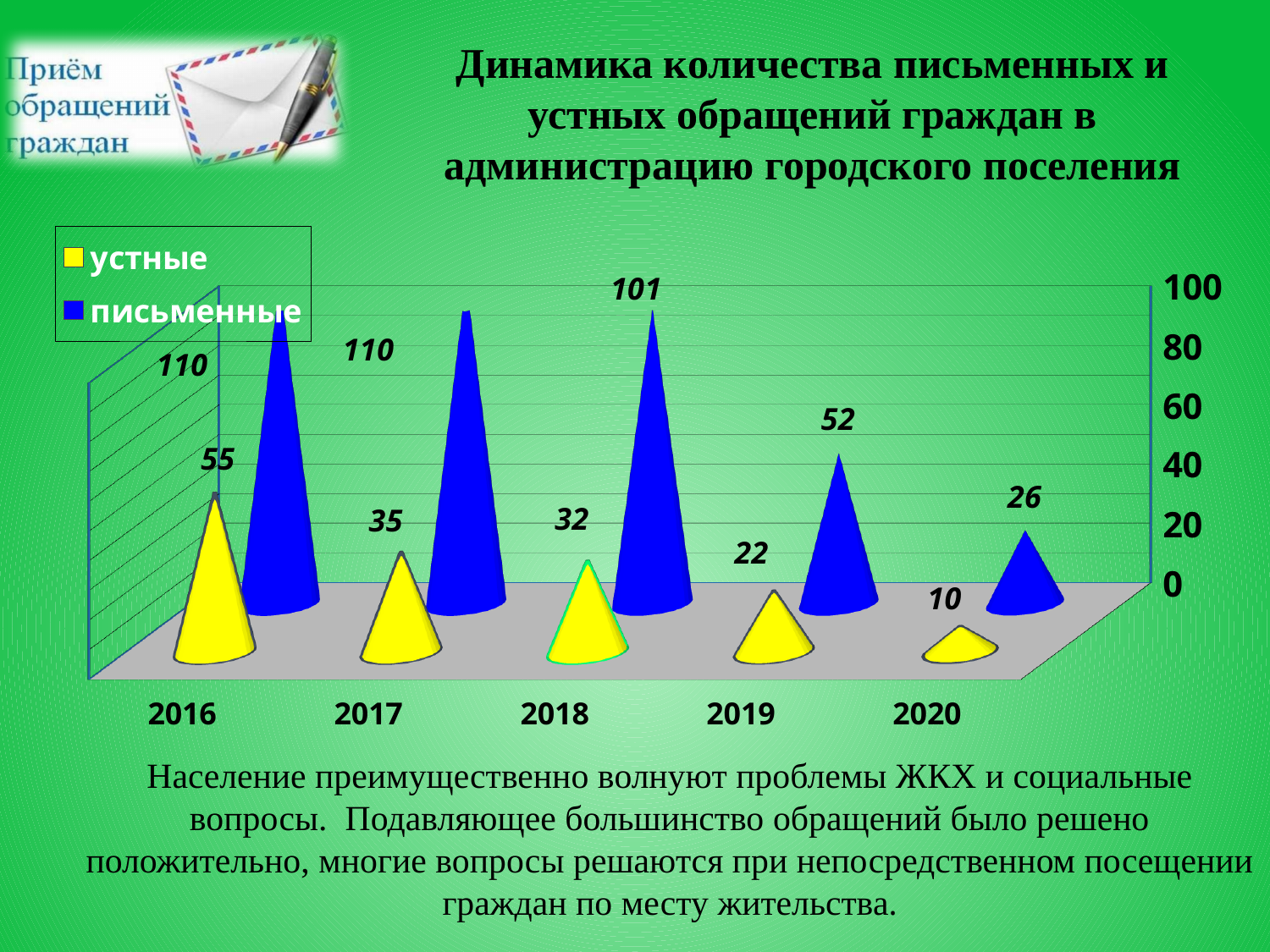
Do the values for устные rise or fall from 2016 to 2020? fall What is the value for письменные in 2018? 101 What is the value for устные in 2016? 55 In which year is the value for устные the lowest? 2020 In which year is the value for письменные the lowest? 2020 What is the value for устные in 2020? 10 What is the difference between письменные and устные in 2019? 30 How many years are shown on the x axis? 5 What kind of chart is shown on the slide? bar chart Which is larger in 2017: устные or письменные? письменные How many series does the legend list? 2 What is the value for письменные in 2019? 52